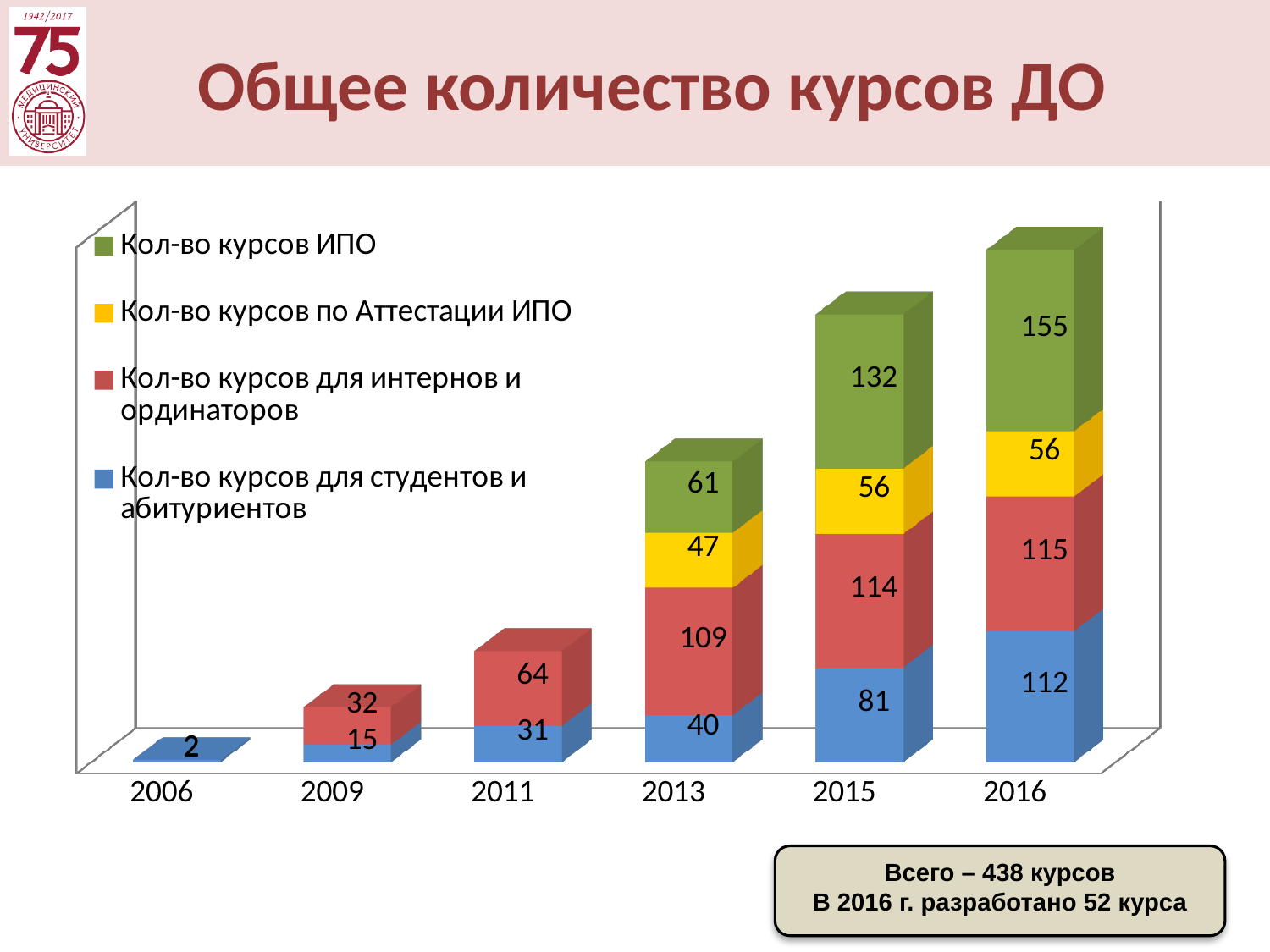
What is the value for 'Кол-во курсов ИПО' in 2016? 155 In which year is the value for 'Кол-во курсов для студентов и абитуриентов' lowest? 2006 What kind of chart is shown on the slide? stacked bar chart What is the value for 'Кол-во курсов для интернов и ординаторов' in 2011? 64 Which is larger: 'Кол-во курсов для интернов и ординаторов' in 2013 or 'Кол-во курсов для студентов и абитуриентов' in 2015? Кол-во курсов для интернов и ординаторов in 2013 In which year is the value for 'Кол-во курсов ИПО' highest? 2016 How many years are shown on the x axis? 6 How many series does the legend list? 4 What is the value for 'Кол-во курсов по Аттестации ИПО' in 2013? 47 What is the value for 'Кол-во курсов для студентов и абитуриентов' in 2009? 15 What is the total of the stacked bar for 2013? 257 What is the difference between the 'Кол-во курсов ИПО' values for 2016 and 2015? 23